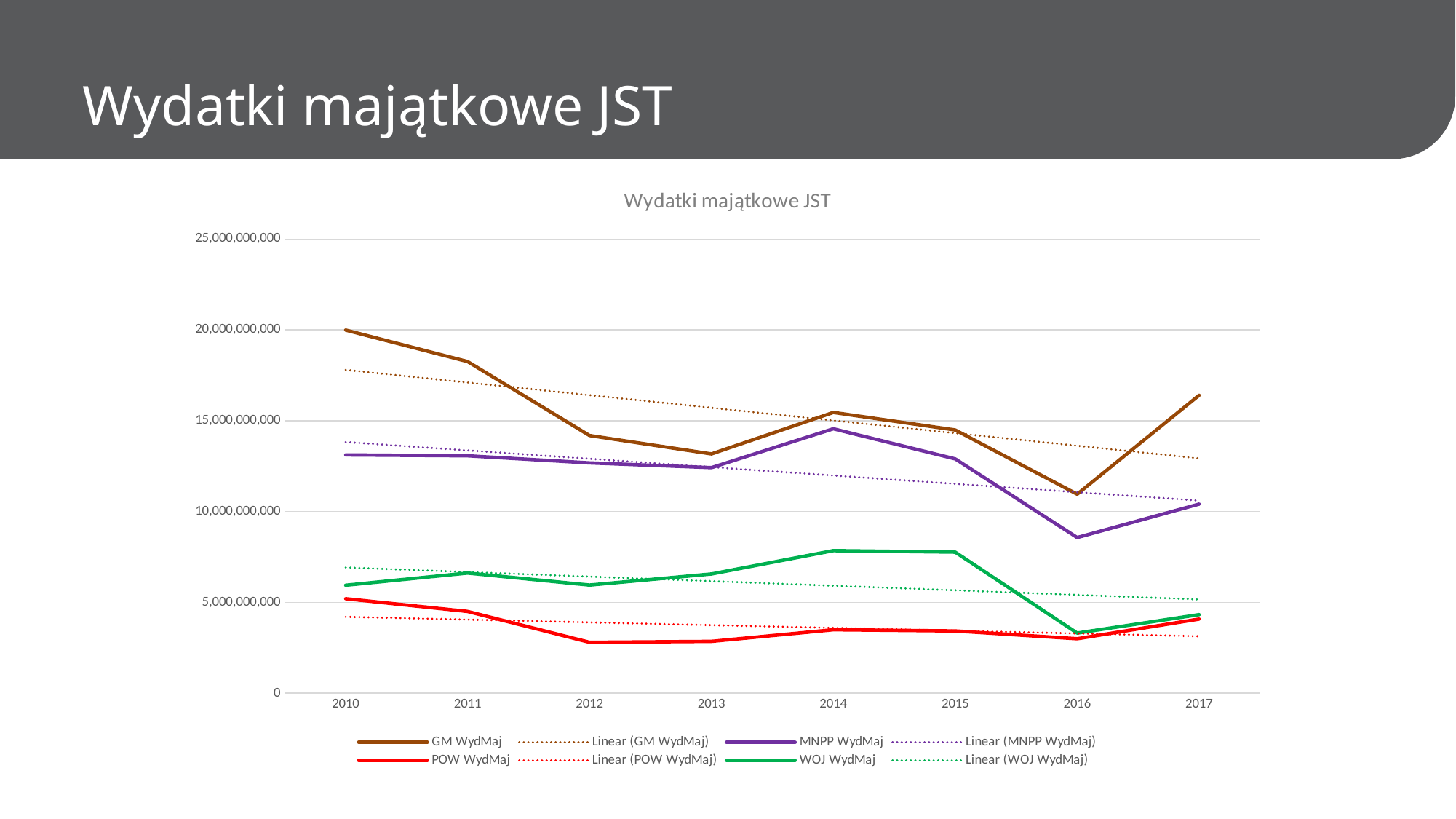
In which year is GM WydMaj lowest? 2016 In which year is MNPP WydMaj highest? 2014 In which year is GM WydMaj highest? 2010 Is the value for GM WydMaj in 2016 greater or less than 10,000,000,000? greater How many years are plotted along the x axis? 8 Does the dotted Linear (GM WydMaj) trendline rise or fall from 2010 to 2017? fall Which is larger in 2010, GM WydMaj or MNPP WydMaj? GM WydMaj Is the value for WOJ WydMaj in 2014 greater or less than 5,000,000,000? greater In which year is WOJ WydMaj lowest? 2016 What kind of chart is shown on the slide? line chart Is the value for MNPP WydMaj in 2016 greater or less than 10,000,000,000? less How many entries does the legend list? 8